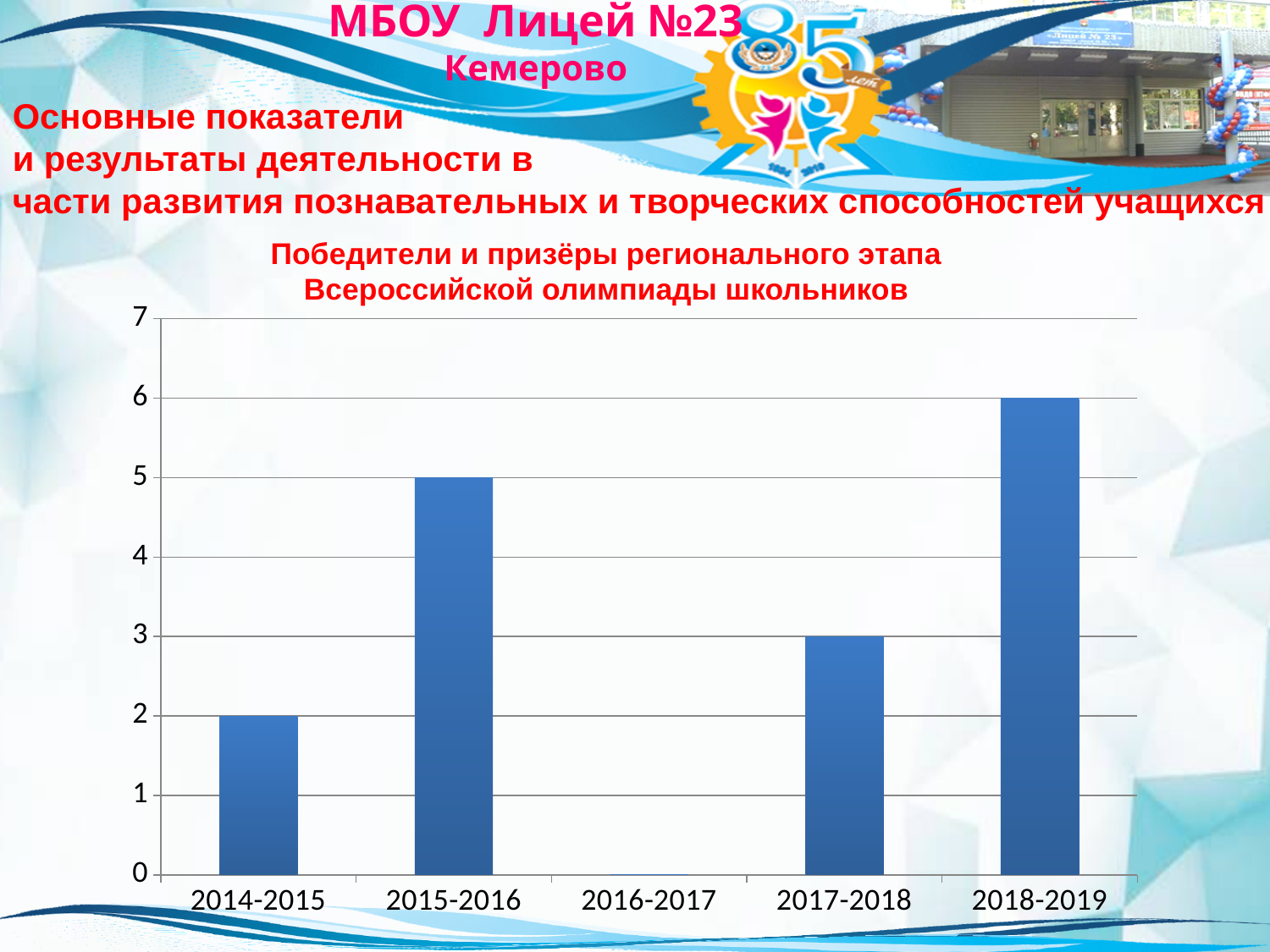
How many categories are shown on the x axis? 5 Which category has the highest value? 2018-2019 What is the value for 2017-2018? 3 What is the difference between the values for 2018-2019 and 2014-2015? 4 What is the value for 2014-2015? 2 What is the value for 2015-2016? 5 What kind of chart is shown on the slide? bar chart Is the value for 2018-2019 greater or less than 4? greater Which is larger, the value for 2015-2016 or the value for 2017-2018? 2015-2016 Which category has the lowest value? 2016-2017 What is the value for 2018-2019? 6 What is the title of the chart? Победители и призёры регионального этапа Всероссийской олимпиады школьников